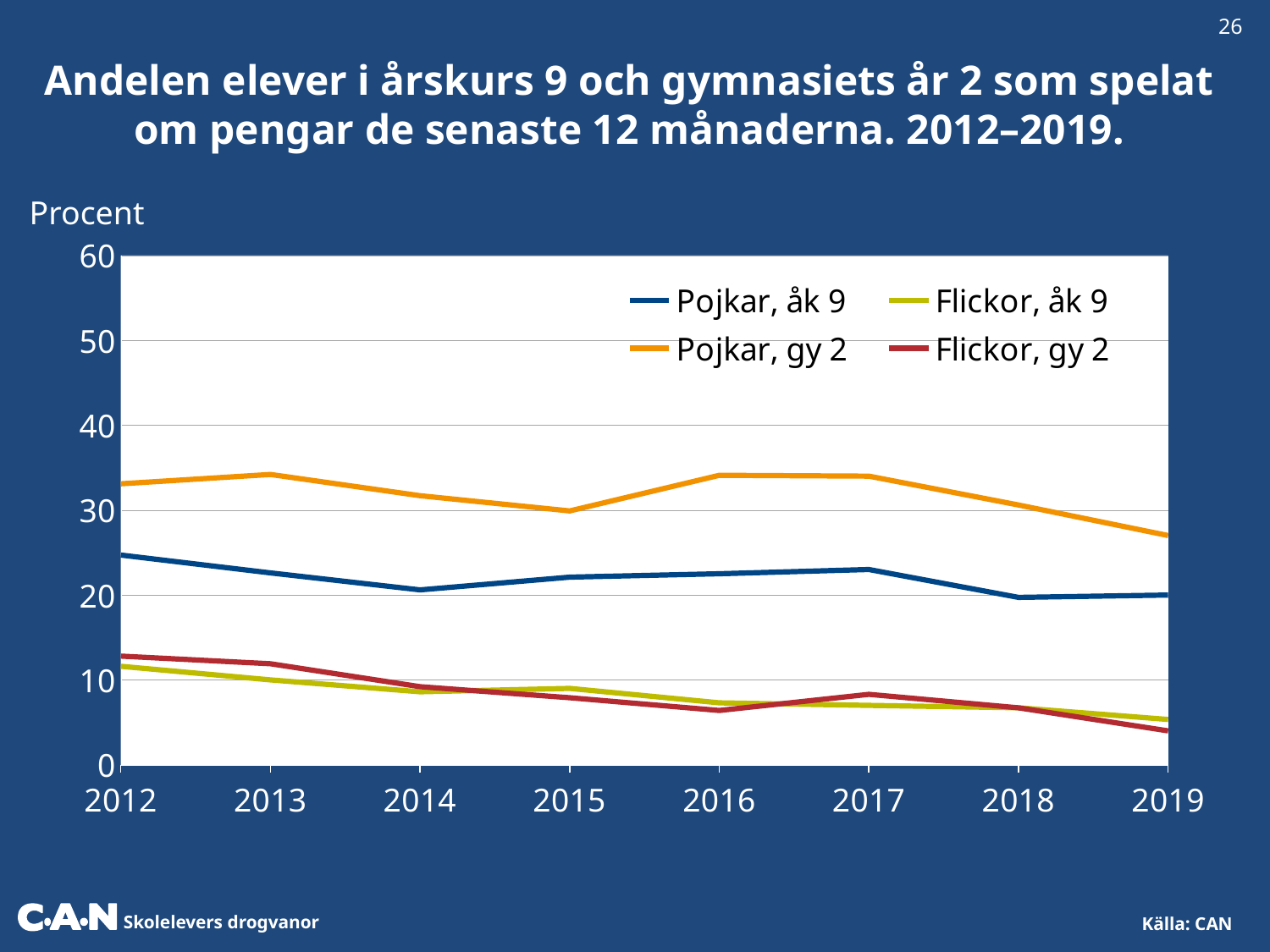
Which series has the highest value in 2019? Pojkar, gy 2 How many years are shown along the x axis? 8 In 2012, which is larger: the value for Pojkar, gy 2 or the value for Pojkar, åk 9? Pojkar, gy 2 Does the value for Flickor, gy 2 rise or fall from 2012 to 2019? fall Is the value for Pojkar, åk 9 in 2012 greater or less than 20? greater How many series does the legend list? 4 Is the value for Pojkar, gy 2 in 2012 greater or less than 30? greater What unit label is shown above the y axis? Procent What colour is the line for Pojkar, gy 2? orange Is the value for Pojkar, åk 9 in 2019 greater or less than 30? less What kind of chart is shown on the slide? line chart